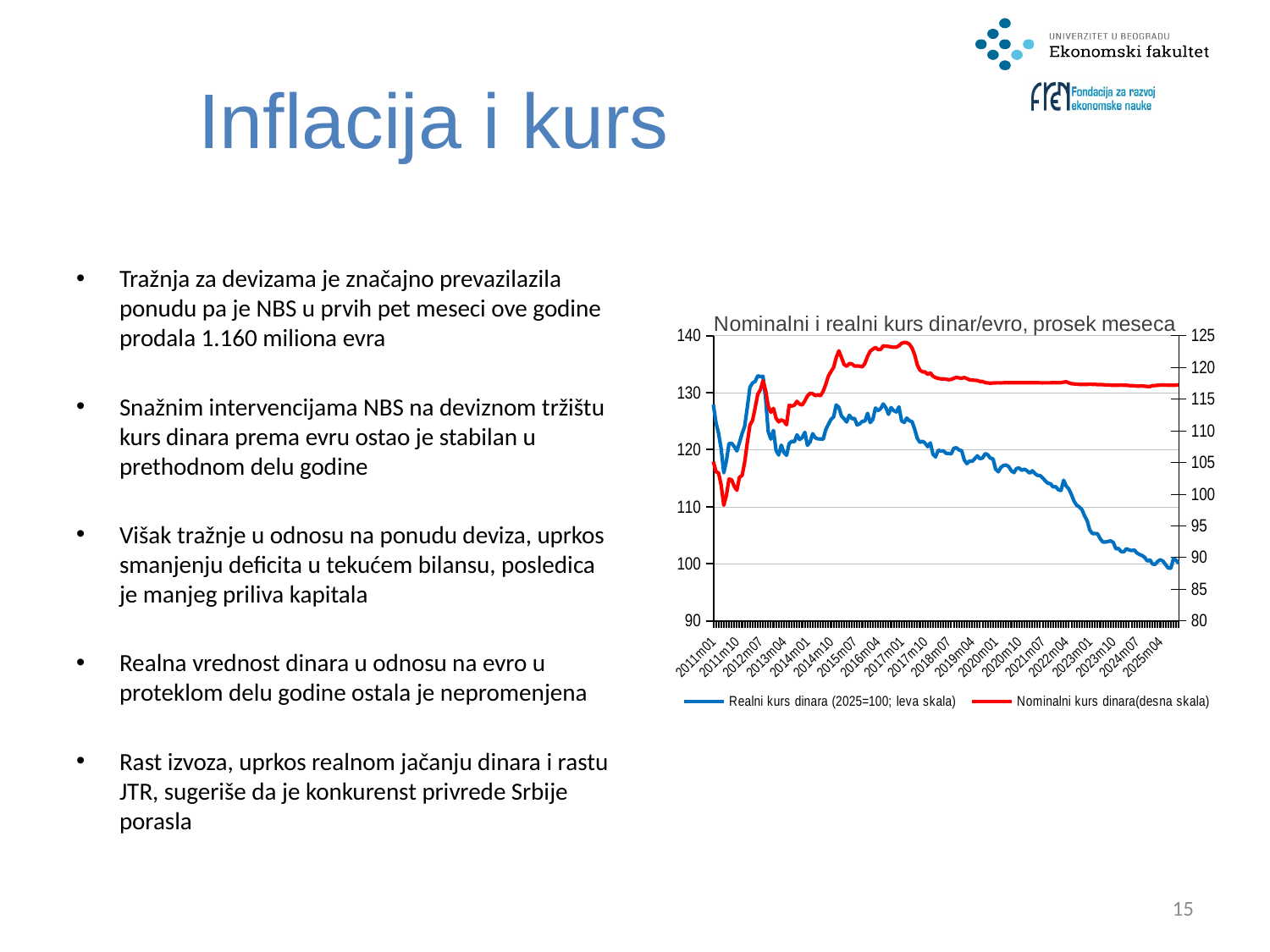
Which series is plotted in red? Nominalni kurs dinara(desna skala) Is the value of the blue line (Realni kurs dinara, left scale) at 2024m07 greater or less than 110? less How many series does the chart legend list? 2 How many labels are shown on the x axis of the chart? 20 Does the blue line (Realni kurs dinara) rise or fall overall from 2011m01 to 2025m04? Fall Near which x-axis label does the red line (Nominalni kurs dinara) reach its highest point? 2017m01 Is the value of the blue line (Realni kurs dinara, left scale) at 2011m01 greater or less than 120? greater Does the red line (Nominalni kurs dinara) rise or fall overall from 2011m01 to 2025m04? Rise What is the title of the chart? Nominalni i realni kurs dinar/evro, prosek meseca Is the value of the red line (Nominalni kurs dinara, right scale) at 2017m01 greater or less than 120? greater What kind of chart is shown on the slide? Line chart